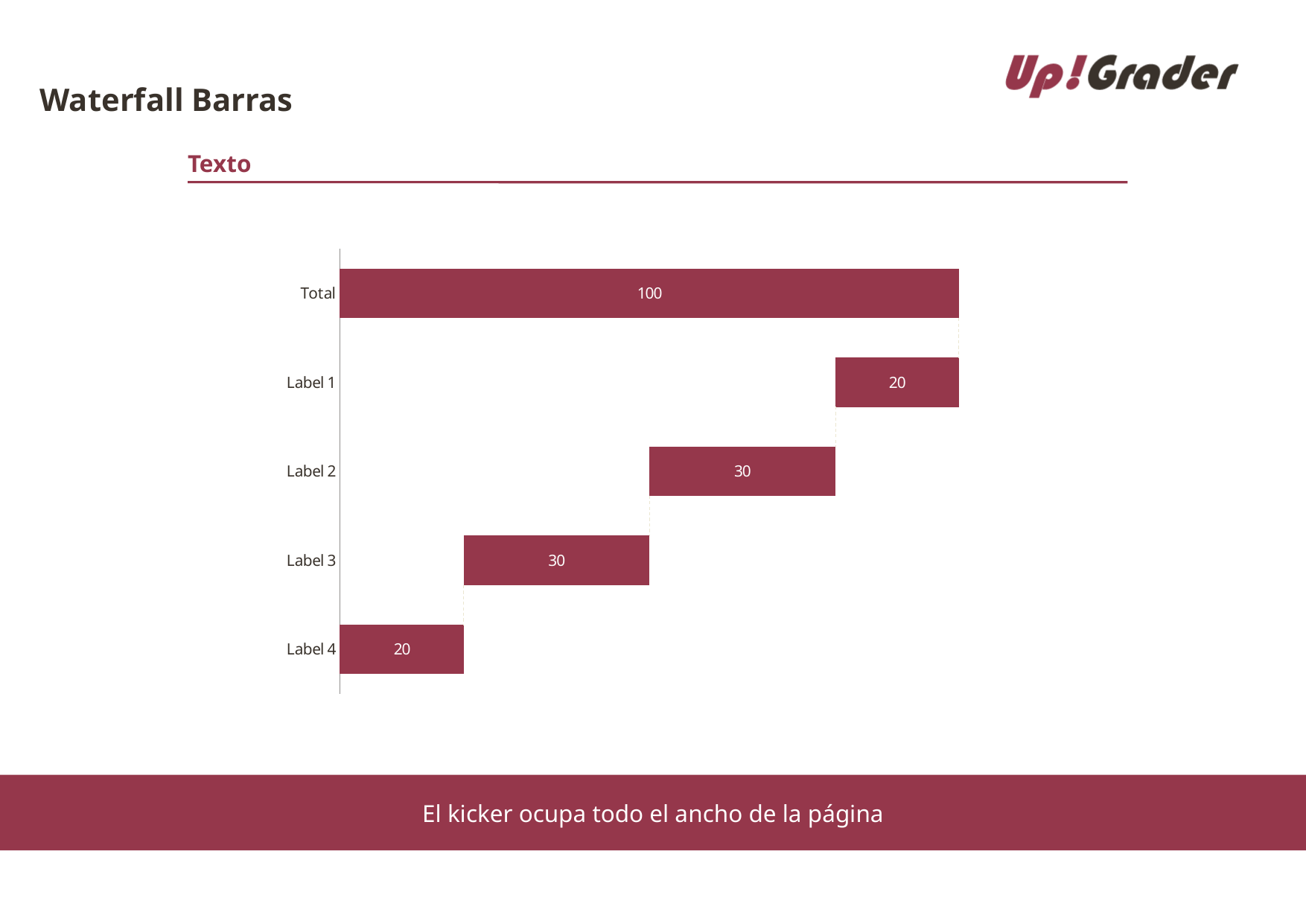
What is the value shown for Label 2? 30 What is the difference between the values for Total and Label 3? 70 What is the value shown for Label 4? 20 What is the title of the slide? Waterfall Barras What is the sum of the values for Label 1, Label 2, Label 3 and Label 4? 100 Which category has the highest value? Total How many categories are shown on the chart? 5 Which is larger, the value for Label 3 or the value for Label 4? Label 3 What is the value shown for Total? 100 What kind of chart is shown on the slide? Bar chart What is the value shown for Label 1? 20 What is the difference between the values for Label 2 and Label 1? 10